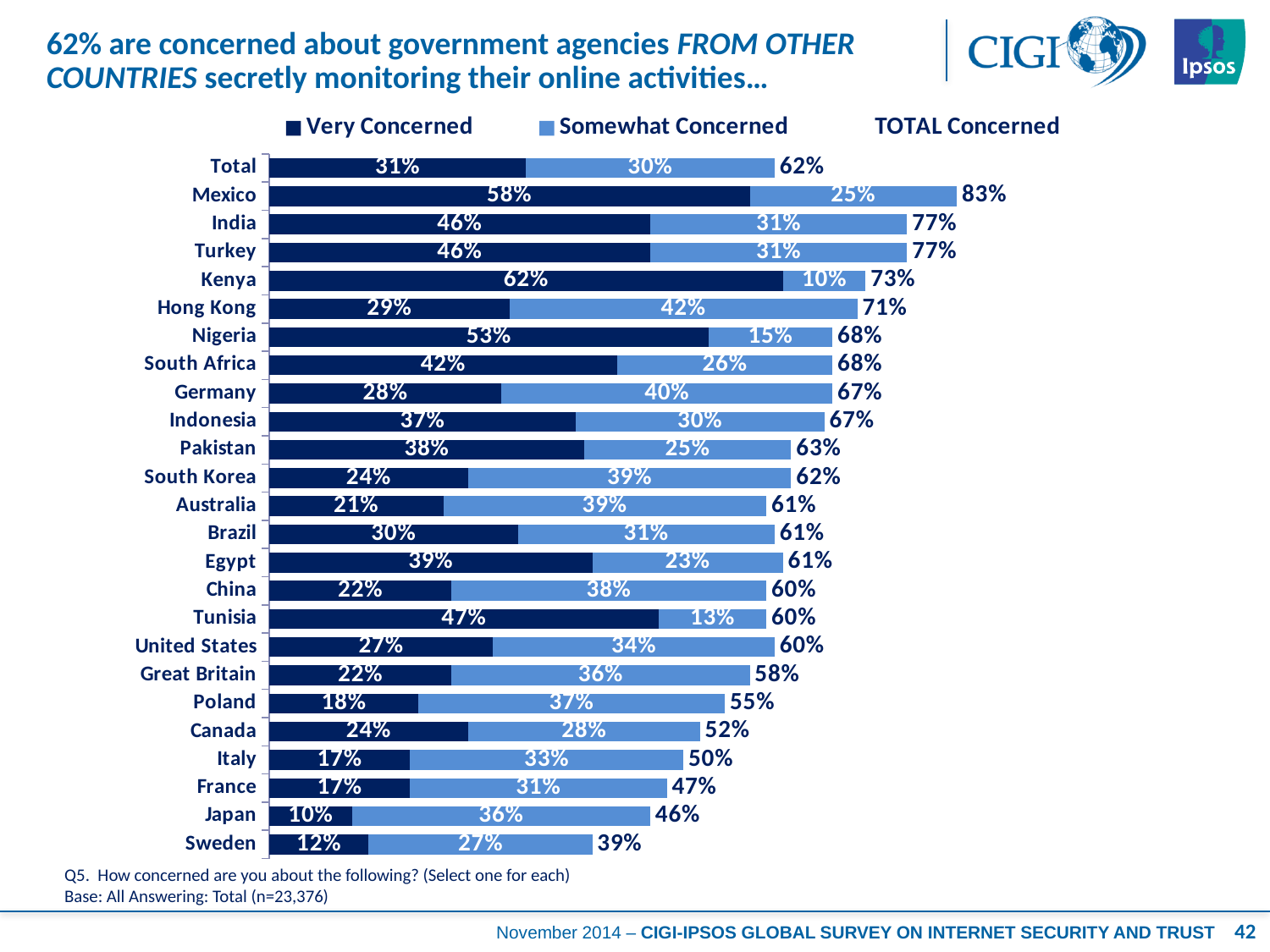
What is the combined Very Concerned and Somewhat Concerned value for Japan? 46% Which has the larger Very Concerned value, Germany or Indonesia? Indonesia What colour represents the Very Concerned series? Dark blue What kind of chart is shown on the slide? Stacked bar chart What is the Very Concerned value for Mexico? 58% What is the TOTAL Concerned value for Sweden? 39% What is the Somewhat Concerned value for Hong Kong? 42% Which country has the lowest TOTAL Concerned value? Sweden How many categories (rows) are plotted in the chart? 25 How much higher is the TOTAL Concerned value for Mexico than for Total? 21 percentage points Which country has the highest TOTAL Concerned value? Mexico Which country has the highest Very Concerned value? Kenya